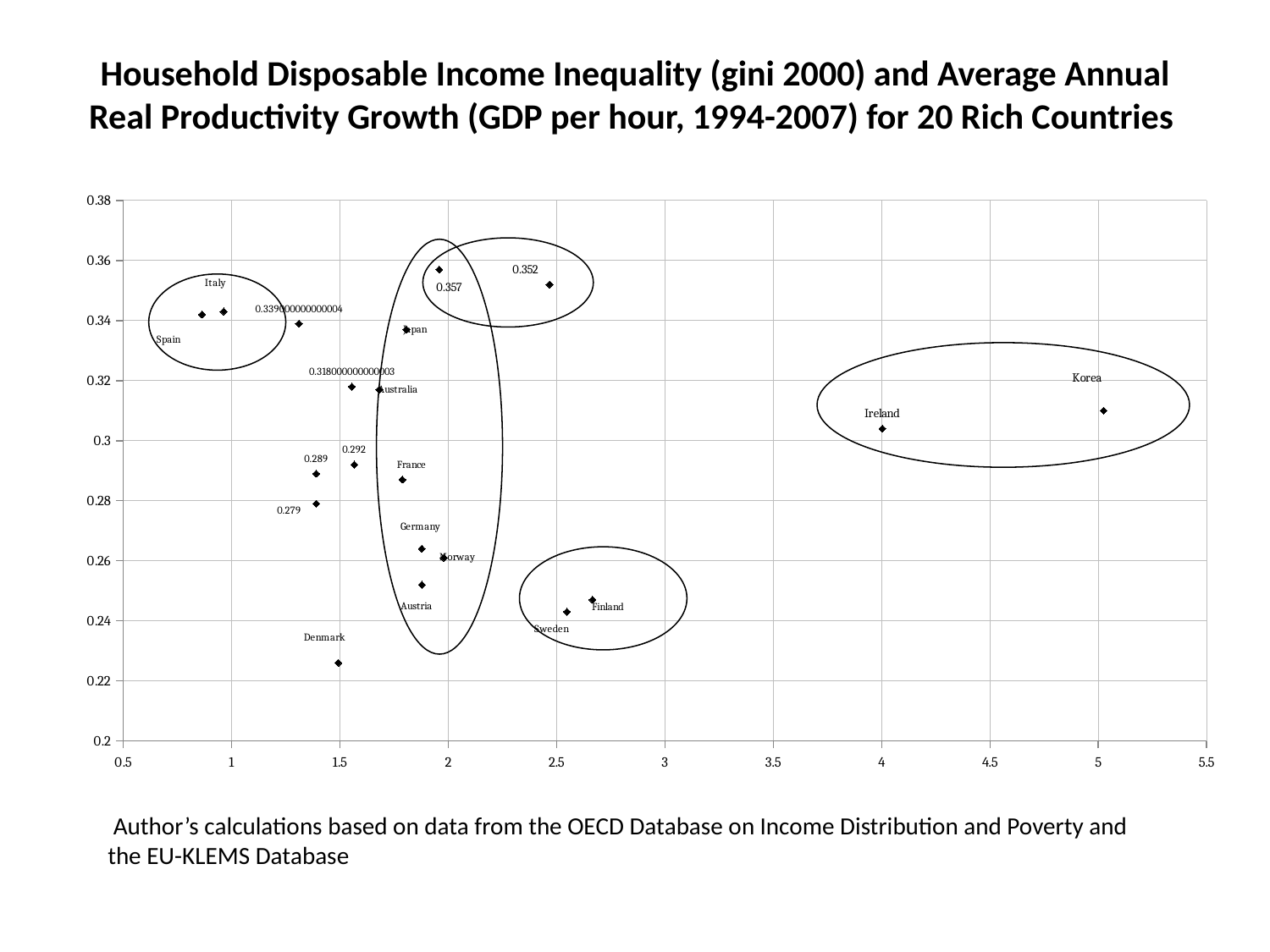
Is the gini value for Japan greater or less than 0.32? greater Is the x-axis value for Ireland greater or less than 3.5? greater Which has the higher x-axis value, Korea or Ireland? Korea What kind of chart is shown on the slide? scatter chart What is the difference between the two data labels 0.357 and 0.352 shown in the upper part of the chart? 0.005 What is the highest gini value printed as a data label on the chart? 0.357 Is the x-axis value for Korea greater or less than 4.5? greater How many data points are plotted on the chart? 20 Which country has the lowest gini value (y-axis value) on the chart? Denmark Which country has the highest productivity growth (x-axis value) on the chart? Korea How many ellipses are drawn around groups of points on the chart? 5